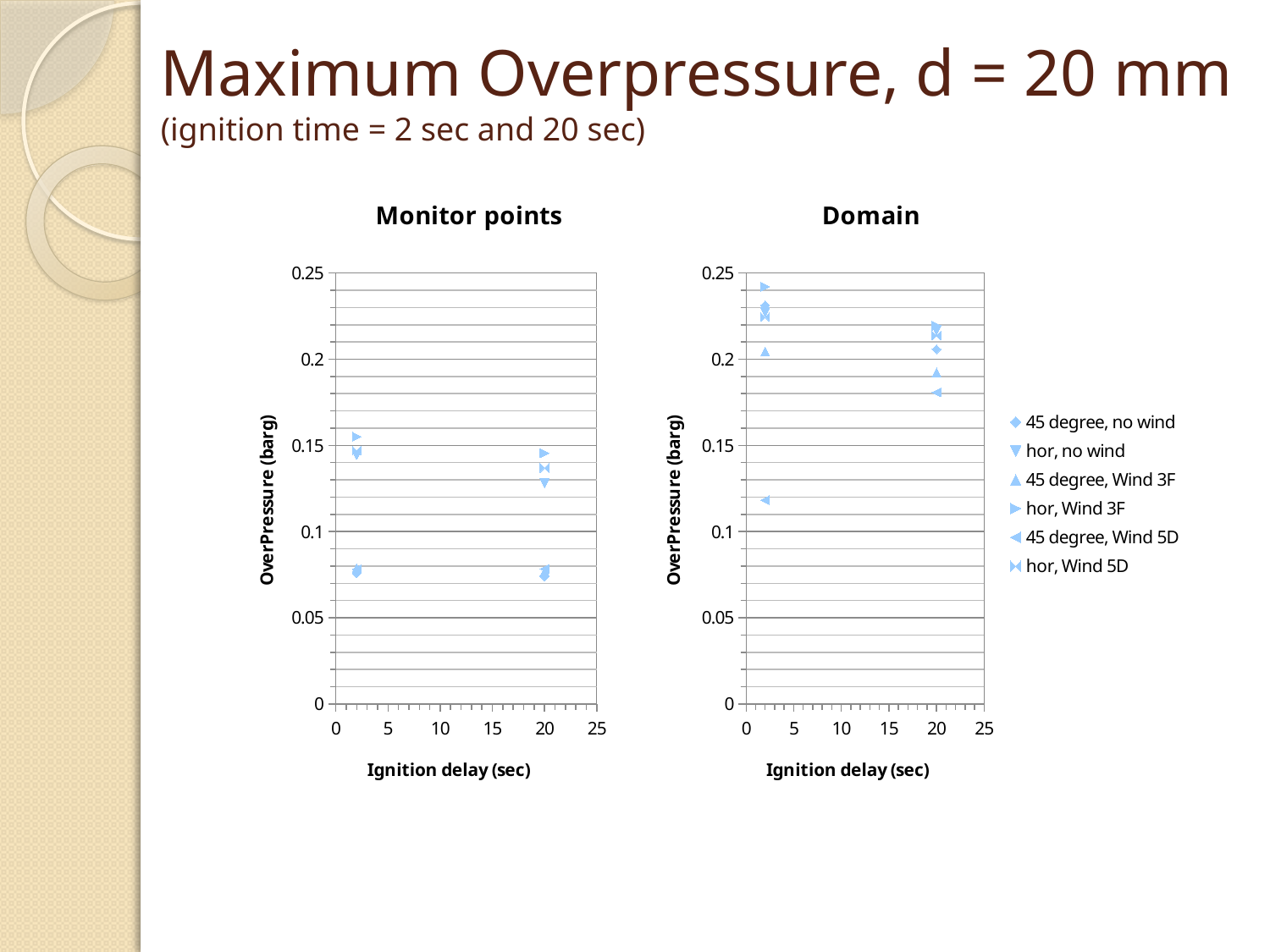
What is the y-axis label of the "Domain" chart? OverPressure (barg) What is the x-axis label of the "Monitor points" chart? Ignition delay (sec) In the "Domain" chart, which series has the lowest plotted point? 45 degree, Wind 5D In the "Domain" chart, does the value for "45 degree, Wind 5D" rise or fall from an ignition delay of 2 sec to 20 sec? rise How many series does the legend list? 6 What kind of chart is the "Monitor points" chart? scatter chart In the "Domain" chart, is the value for "45 degree, Wind 5D" at an ignition delay of 2 sec greater or less than 0.15? less In the "Monitor points" chart, is the value for "45 degree, no wind" at an ignition delay of 20 sec greater or less than 0.1? less In the "Monitor points" chart, does the value for "hor, no wind" rise or fall from an ignition delay of 2 sec to 20 sec? fall In the "Domain" chart, is the value for "hor, Wind 3F" at an ignition delay of 2 sec greater or less than 0.2? greater In the "Domain" chart, which series has the highest plotted point? hor, Wind 3F